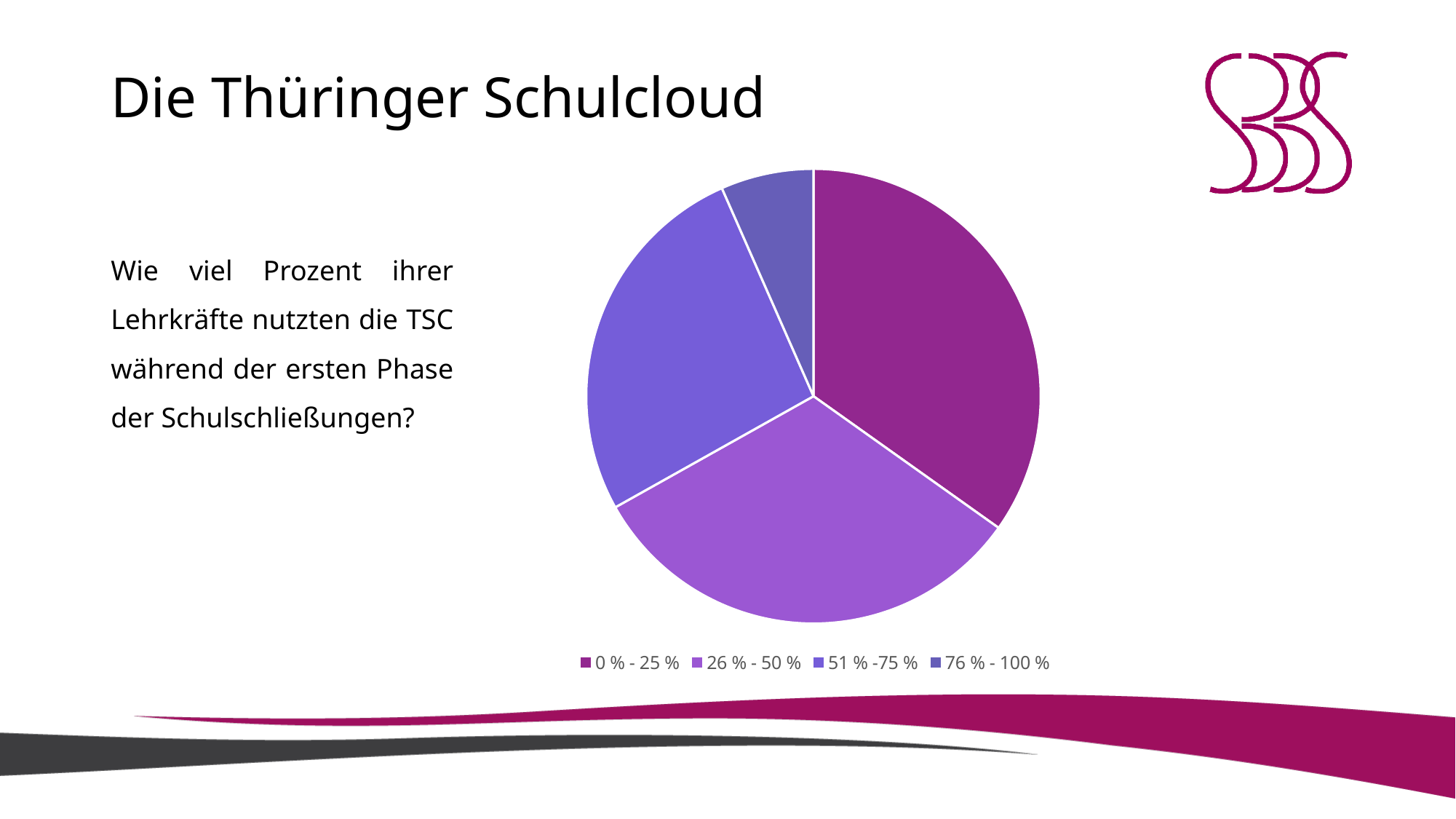
Which slice is larger, 26 % - 50 % or 76 % - 100 %? 26 % - 50 % How many slices does the pie chart have? 4 Which category has the smallest slice of the pie chart? 76 % - 100 % How many entries does the legend of the pie chart list? 4 What is the last entry listed in the legend of the pie chart? 76 % - 100 % Which slice is larger, 0 % - 25 % or 26 % - 50 %? 0 % - 25 % What is the first entry listed in the legend of the pie chart? 0 % - 25 % What kind of chart is shown on the slide? pie chart Which slice is larger, 51 % -75 % or 76 % - 100 %? 51 % -75 % Which category has the largest slice of the pie chart? 0 % - 25 %